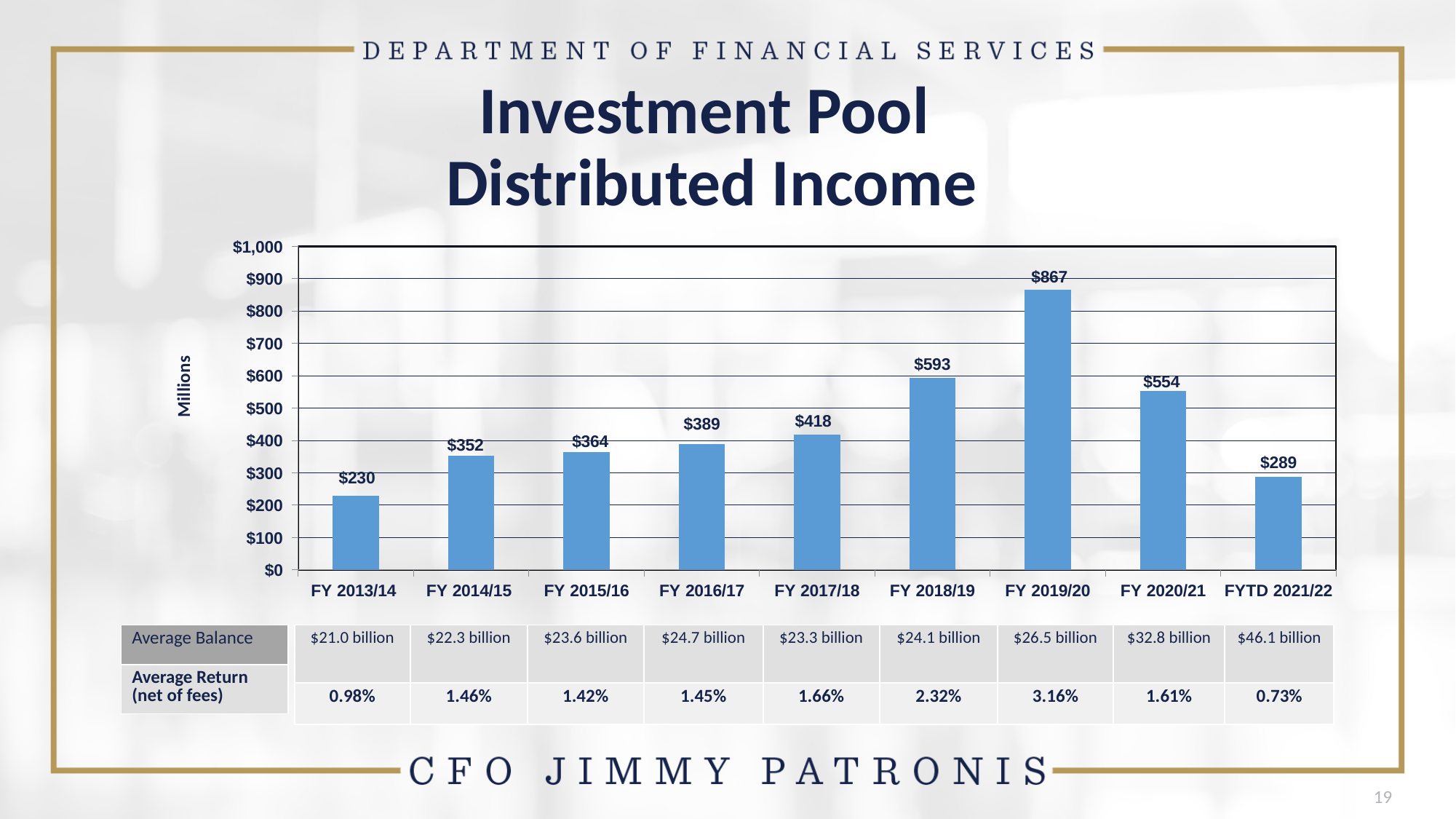
How many fiscal years are shown on the x axis of the chart? 9 Is the distributed income for FY 2018/19 greater or less than $500? greater Which fiscal year has the lowest distributed income? FY 2013/14 What kind of chart is shown on the slide? bar chart What is the label on the vertical axis of the chart? Millions What is the distributed income for FYTD 2021/22? $289 What is the difference in distributed income between FY 2019/20 and FY 2020/21? $313 Does the distributed income rise or fall from FY 2013/14 to FY 2019/20? rise What is the distributed income for FY 2019/20? $867 What is the distributed income for FY 2013/14? $230 Which is larger, the distributed income for FY 2015/16 or FY 2016/17? FY 2016/17 Which fiscal year has the highest distributed income? FY 2019/20